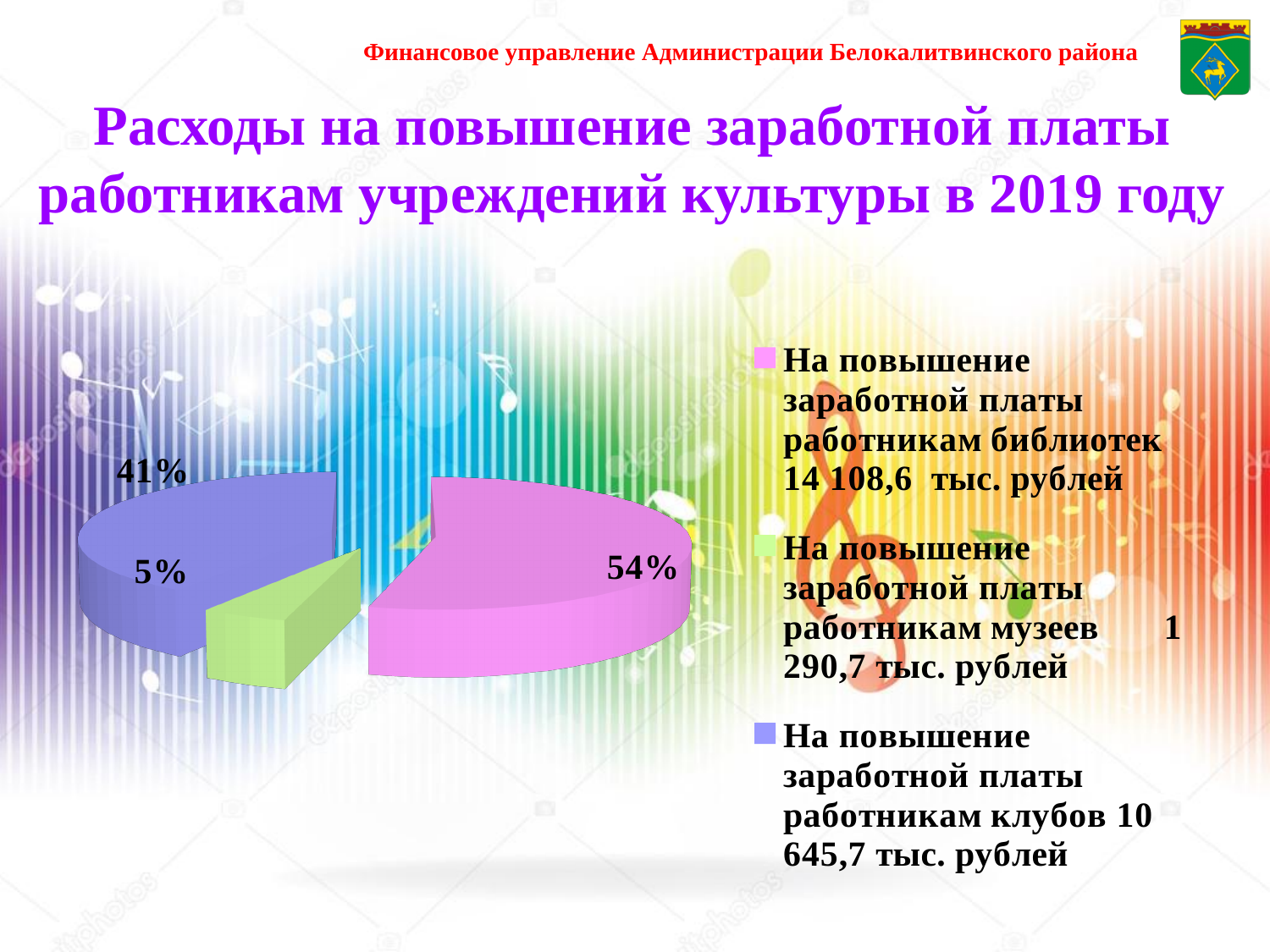
How many entries does the legend list? 3 Which category has the largest share of the pie? На повышение заработной платы работникам библиотек What share of the pie is the slice for raising wages of club workers (работникам клубов)? 41% What share of the pie is the slice for raising wages of library workers (работникам библиотек)? 54% According to the legend, how much is spent on raising wages of library workers? 14 108,6 тыс. рублей How many slices does the pie chart have? 3 What is the difference in percentage points between the library workers slice and the club workers slice? 13 What colour is the slice for raising wages of club workers? blue What kind of chart is shown on the slide? pie chart What share of the pie is the slice for raising wages of museum workers (работникам музеев)? 5% Which category has the smallest share of the pie? На повышение заработной платы работникам музеев Which slice is larger: the one for club workers or the one for museum workers? club workers (работникам клубов)